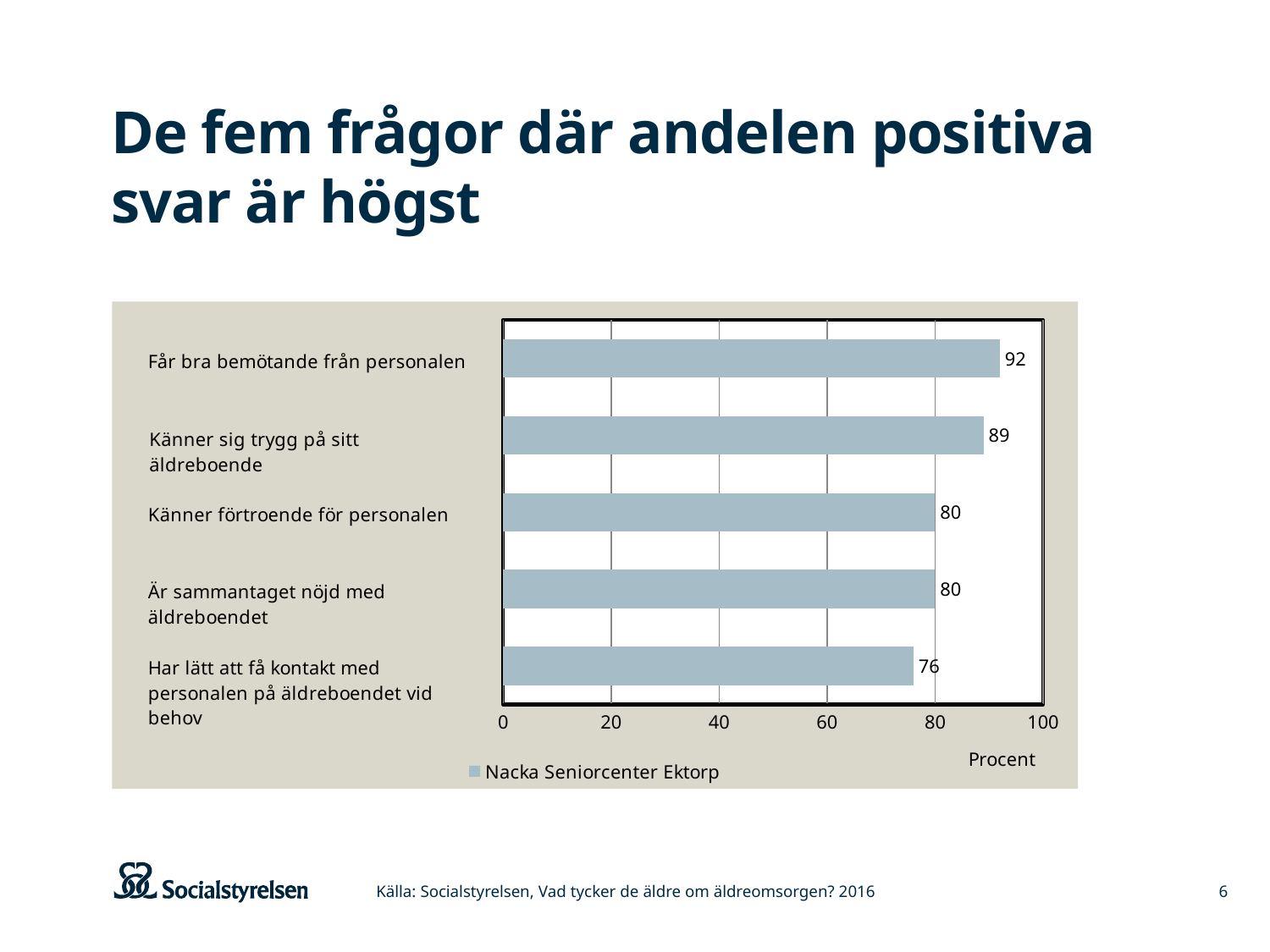
What kind of chart is shown on the slide? Bar chart What is the value for "Får bra bemötande från personalen"? 92 What is the series name shown in the legend? Nacka Seniorcenter Ektorp What is the value for "Känner sig trygg på sitt äldreboende"? 89 What is the difference between the values for "Får bra bemötande från personalen" and "Har lätt att få kontakt med personalen på äldreboendet vid behov"? 16 Which category has the highest value? Får bra bemötande från personalen What is the value for "Har lätt att få kontakt med personalen på äldreboendet vid behov"? 76 What is the value for "Känner förtroende för personalen"? 80 How many series does the legend list? 1 Which is larger: the value for "Känner sig trygg på sitt äldreboende" or the value for "Är sammantaget nöjd med äldreboendet"? Känner sig trygg på sitt äldreboende How many categories are shown in the chart? 5 Which category has the lowest value? Har lätt att få kontakt med personalen på äldreboendet vid behov